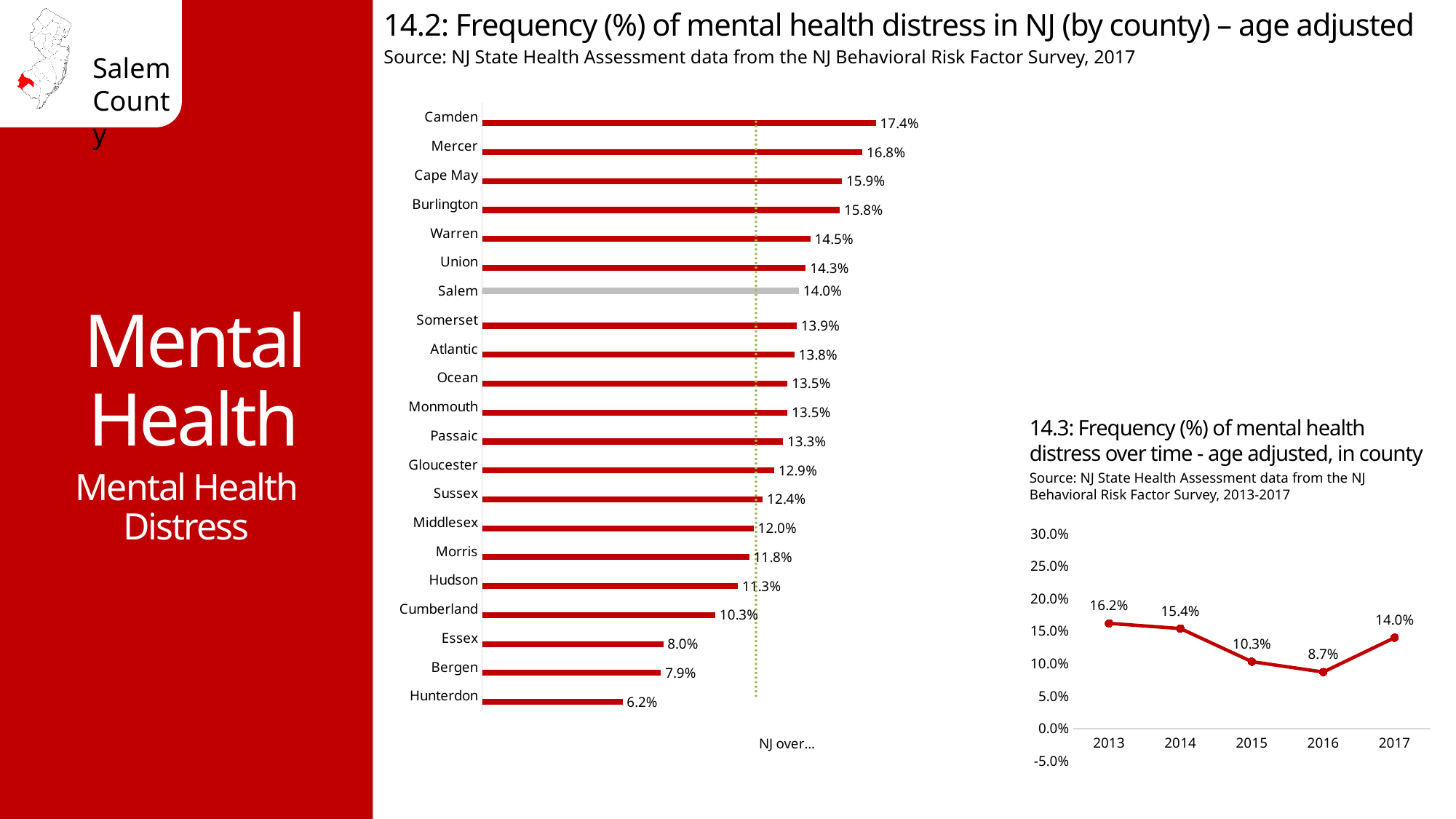
In chart 14.2 (by county), how many counties are shown? 21 In chart 14.3 (over time), how many years are plotted? 5 In chart 14.2 (by county), what is the difference between Camden and Hunterdon? 11.2% In chart 14.3 (over time), what is the difference between 2013 and 2016? 7.5% In chart 14.3 (over time), which year has the highest value? 2013 In chart 14.2 (by county), which county has the highest value? Camden In chart 14.2 (by county), which is larger, the value for Mercer or the value for Cape May? Mercer In chart 14.2 (by county), what is the value for Cumberland? 10.3% In chart 14.2 (by county), which county has the lowest value? Hunterdon What kind of chart is chart 14.2 (by county)? Bar chart In chart 14.2 (by county), what is the value for Salem? 14.0% In chart 14.3 (over time), what is the value for 2016? 8.7%